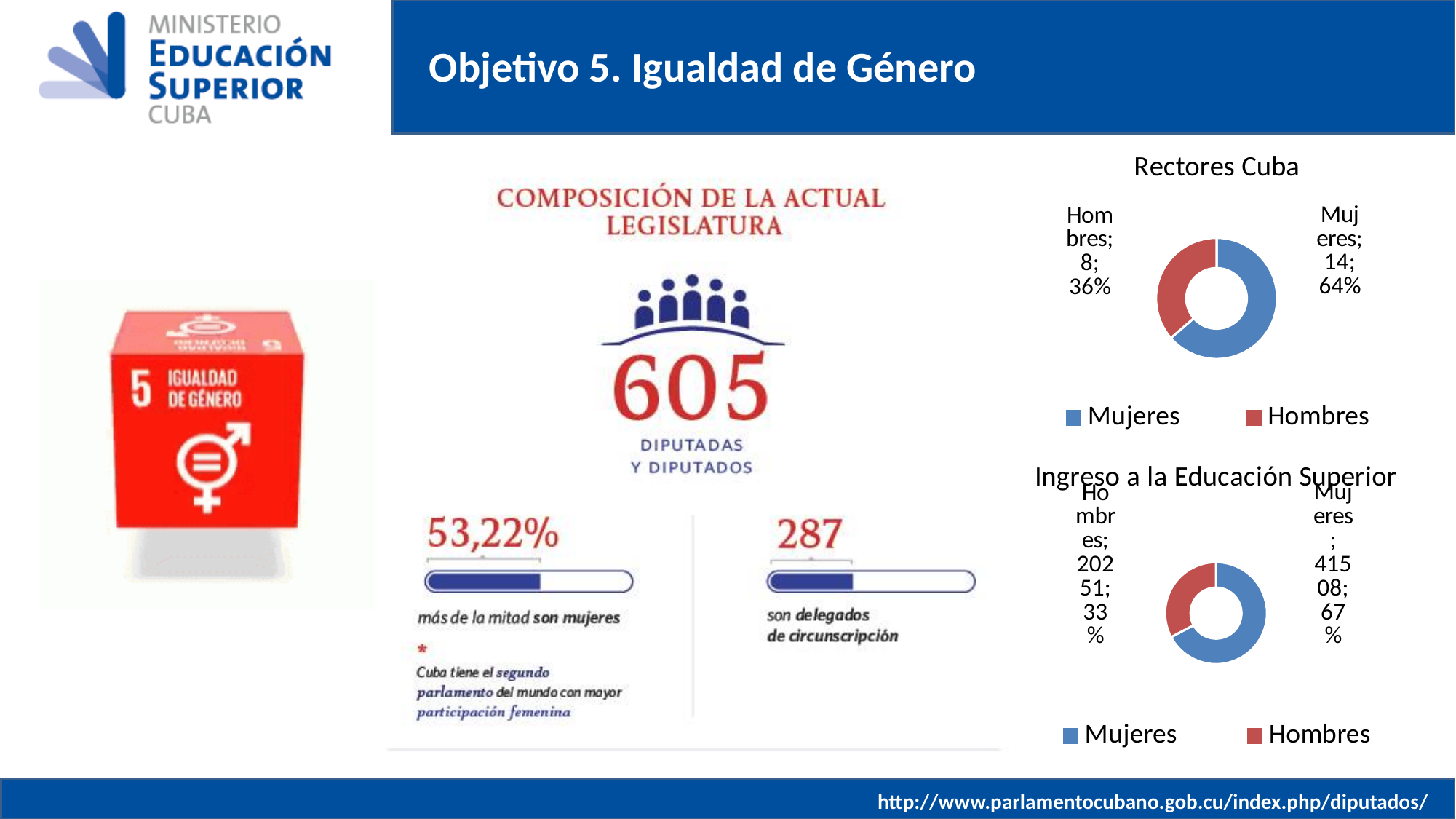
In the 'Rectores Cuba' chart, what share of the total do Hombres represent? 36% In the 'Rectores Cuba' chart, what share of the total do Mujeres represent? 64% What kind of chart is the 'Rectores Cuba' chart? Doughnut chart In the 'Rectores Cuba' chart, which category is larger, Mujeres or Hombres? Mujeres In the 'Ingreso a la Educación Superior' chart, what is the value for Mujeres? 41508 How many entries does the legend of the 'Ingreso a la Educación Superior' chart list? 2 In the 'Rectores Cuba' chart, what is the value for Hombres? 8 In the 'Rectores Cuba' chart, what is the difference between the Mujeres and Hombres values? 6 In the 'Ingreso a la Educación Superior' chart, what is the value for Hombres? 20251 In the 'Ingreso a la Educación Superior' chart, which category is the largest? Mujeres In the 'Rectores Cuba' chart, what is the value for Mujeres? 14 In the 'Ingreso a la Educación Superior' chart, what share of the total do Mujeres represent? 67%